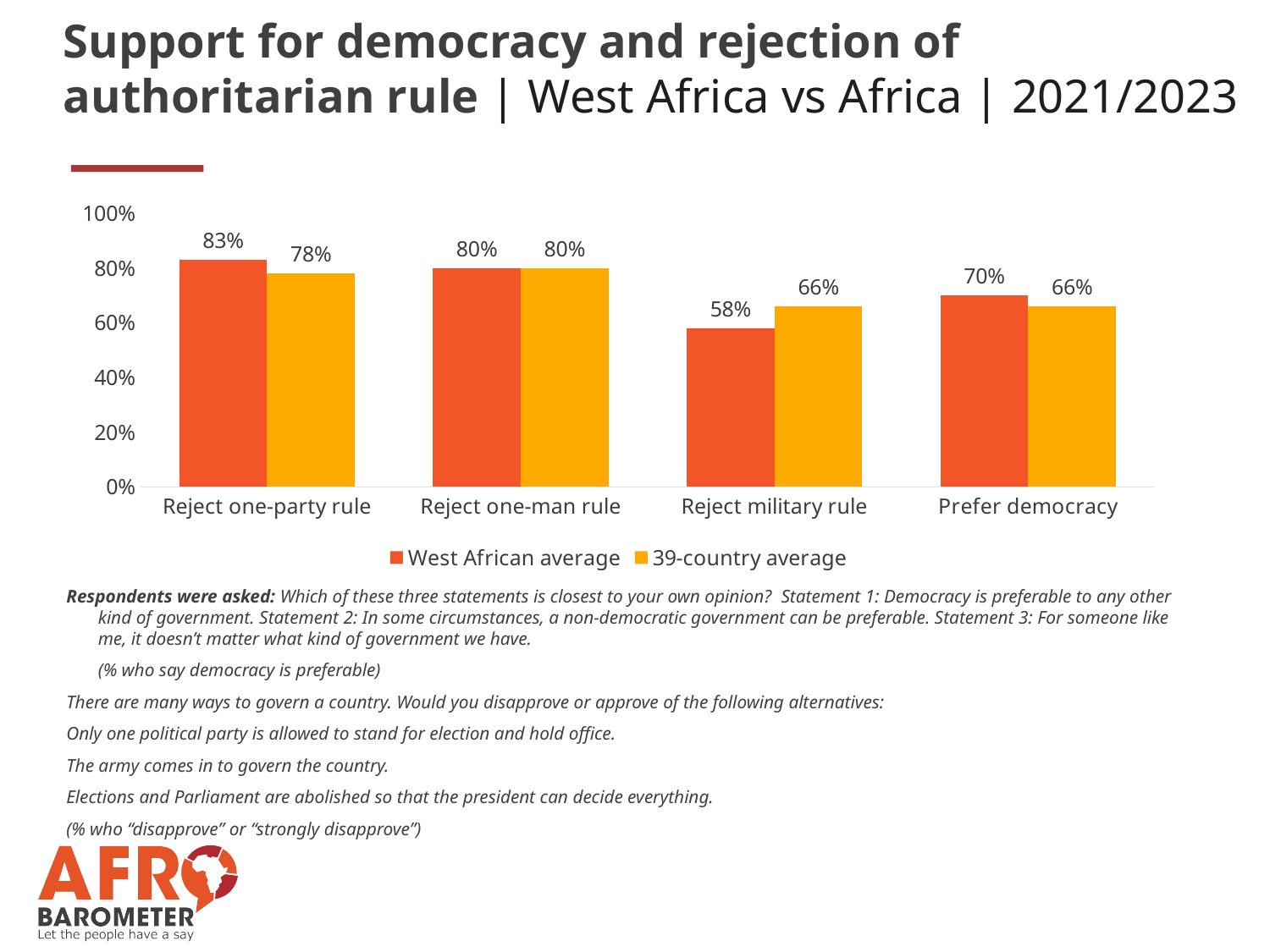
Which category has the highest West African average? Reject one-party rule What is the West African average for 'Prefer democracy'? 70% Which series is shown in orange-red (the left bar of each pair)? West African average What is the 39-country average for 'Reject military rule'? 66% How many categories are shown on the x axis? 4 What is the West African average for 'Reject one-party rule'? 83% What is the difference between the 39-country average and the West African average for 'Reject military rule'? 8 percentage points Which category has the lowest West African average? Reject military rule For 'Prefer democracy', which is larger: the West African average or the 39-country average? West African average How many series does the legend list? 2 What kind of chart is shown on the slide? Bar chart Is the West African average for 'Reject military rule' greater or less than 60%? less